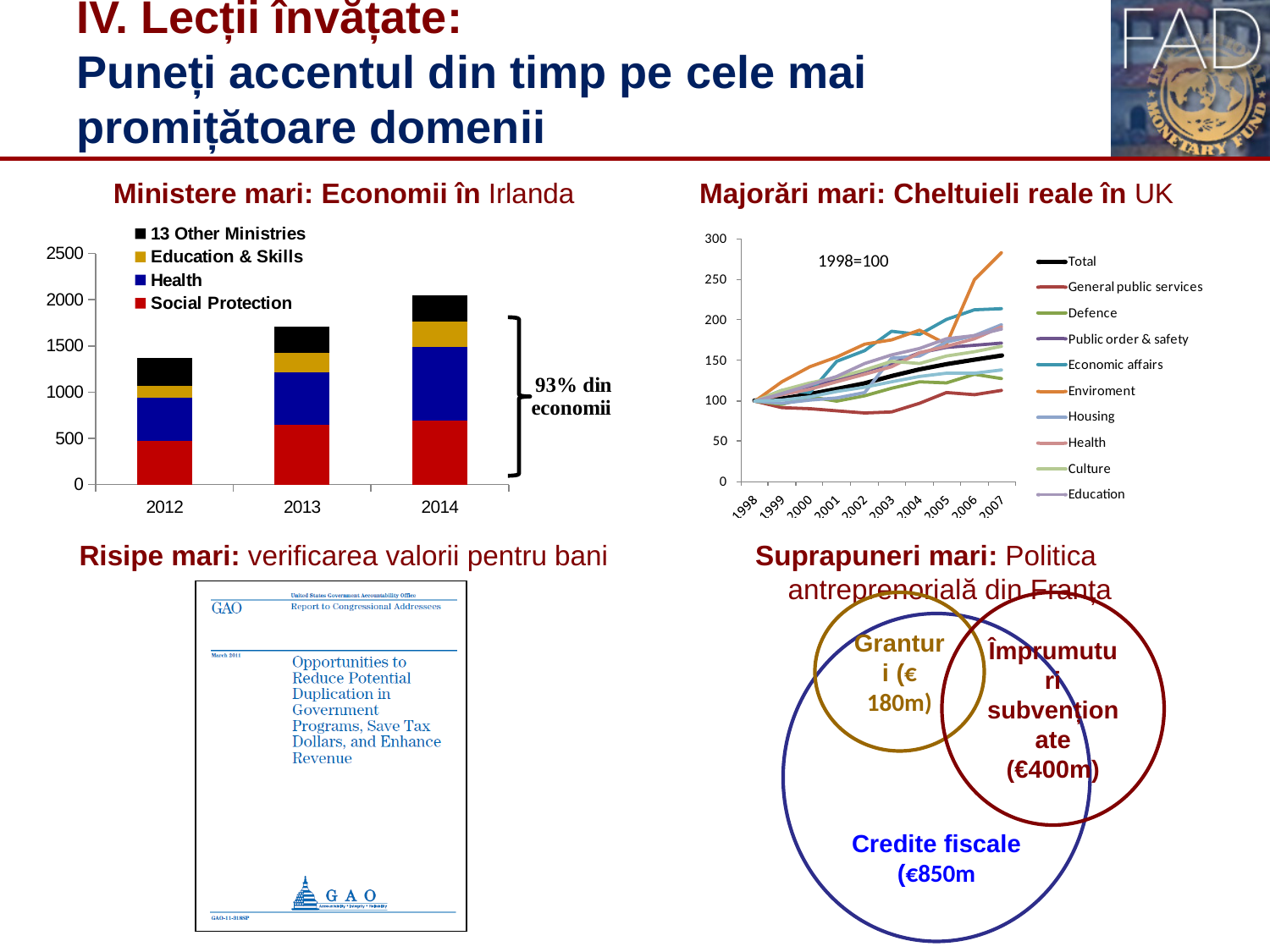
How many years are shown on the x axis of the 'Ministere mari: Economii în Irlanda' chart? 3 What kind of chart is the 'Ministere mari: Economii în Irlanda' chart? bar chart What kind of chart is the 'Majorări mari: Cheltuieli reale în UK' chart? line chart In the 'Ministere mari: Economii în Irlanda' chart, do the total stacked bars rise or fall from 2012 to 2014? rise In the 'Majorări mari: Cheltuieli reale în UK' chart, is the value for Enviroment in 2007 greater or less than 250? greater In the 'Ministere mari: Economii în Irlanda' chart, is the total stacked bar for 2013 greater or less than 1500? greater In the 'Ministere mari: Economii în Irlanda' chart, is the total stacked bar for 2012 greater or less than 1500? less In the 'Ministere mari: Economii în Irlanda' chart, which year has the shortest stacked bar? 2012 How many series does the legend of the 'Ministere mari: Economii în Irlanda' chart list? 4 In the 'Majorări mari: Cheltuieli reale în UK' chart, which series has the highest value in 2007? Enviroment In the 'Ministere mari: Economii în Irlanda' chart, which year has the tallest stacked bar? 2014 How many series does the legend of the 'Majorări mari: Cheltuieli reale în UK' chart list? 10